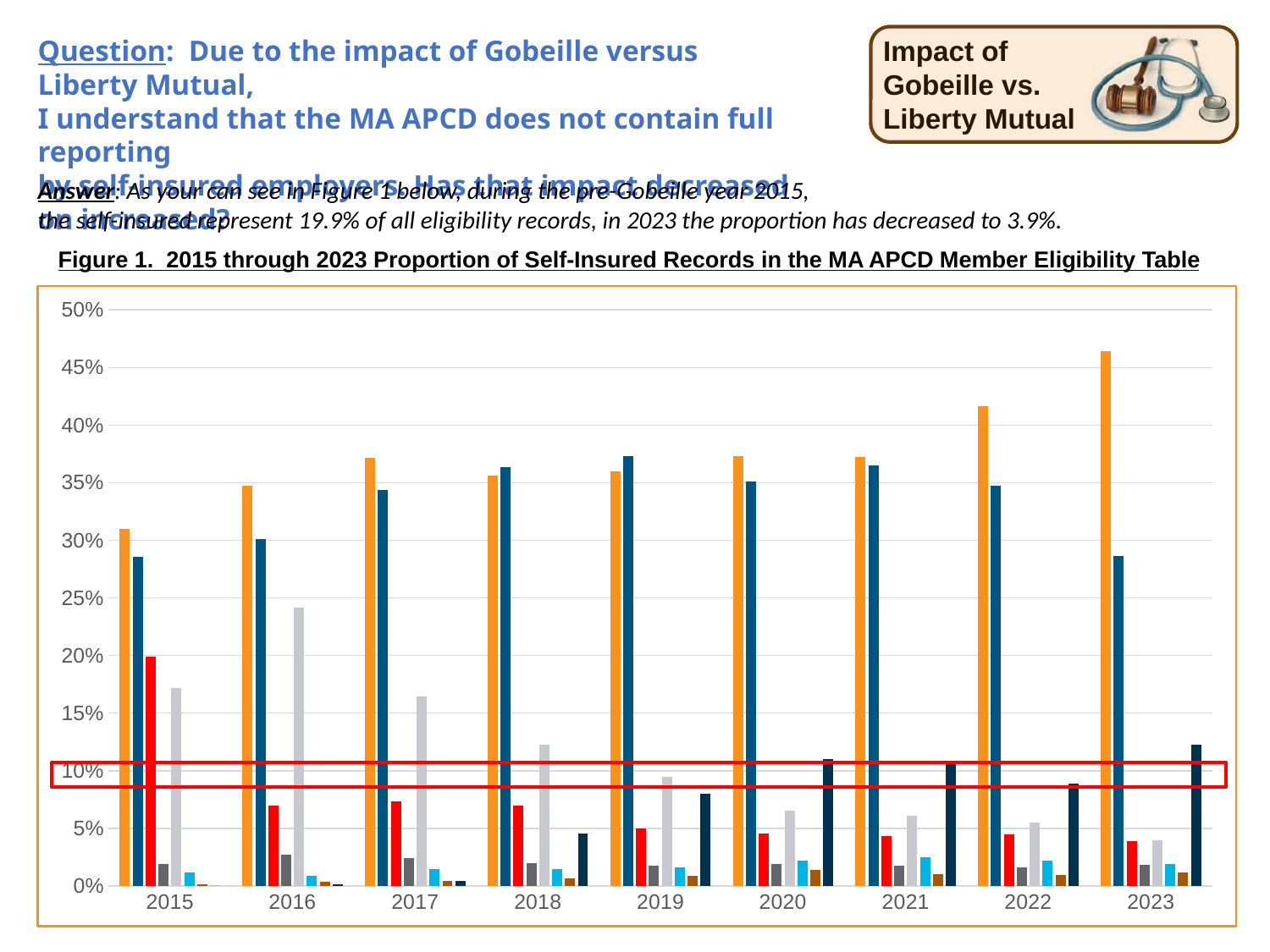
In which year is the orange bar the shortest? 2015 Is the orange bar for 2023 greater or less than 45%? greater How many years are shown along the x axis of the chart? 9 Which is larger, the dark blue bar for 2015 or the dark blue bar for 2019? 2019 Do the orange bars generally rise or fall from 2015 to 2023? rise In which year is the orange bar the tallest? 2023 What is the highest value shown on the y axis of the chart? 50% Is the red bar for 2023 greater or less than 5%? less What is the title of the chart? Figure 1. 2015 through 2023 Proportion of Self-Insured Records in the MA APCD Member Eligibility Table What kind of chart is shown in Figure 1? bar chart In which year is the red bar the tallest? 2015 Is the red bar for 2015 greater or less than 15%? greater